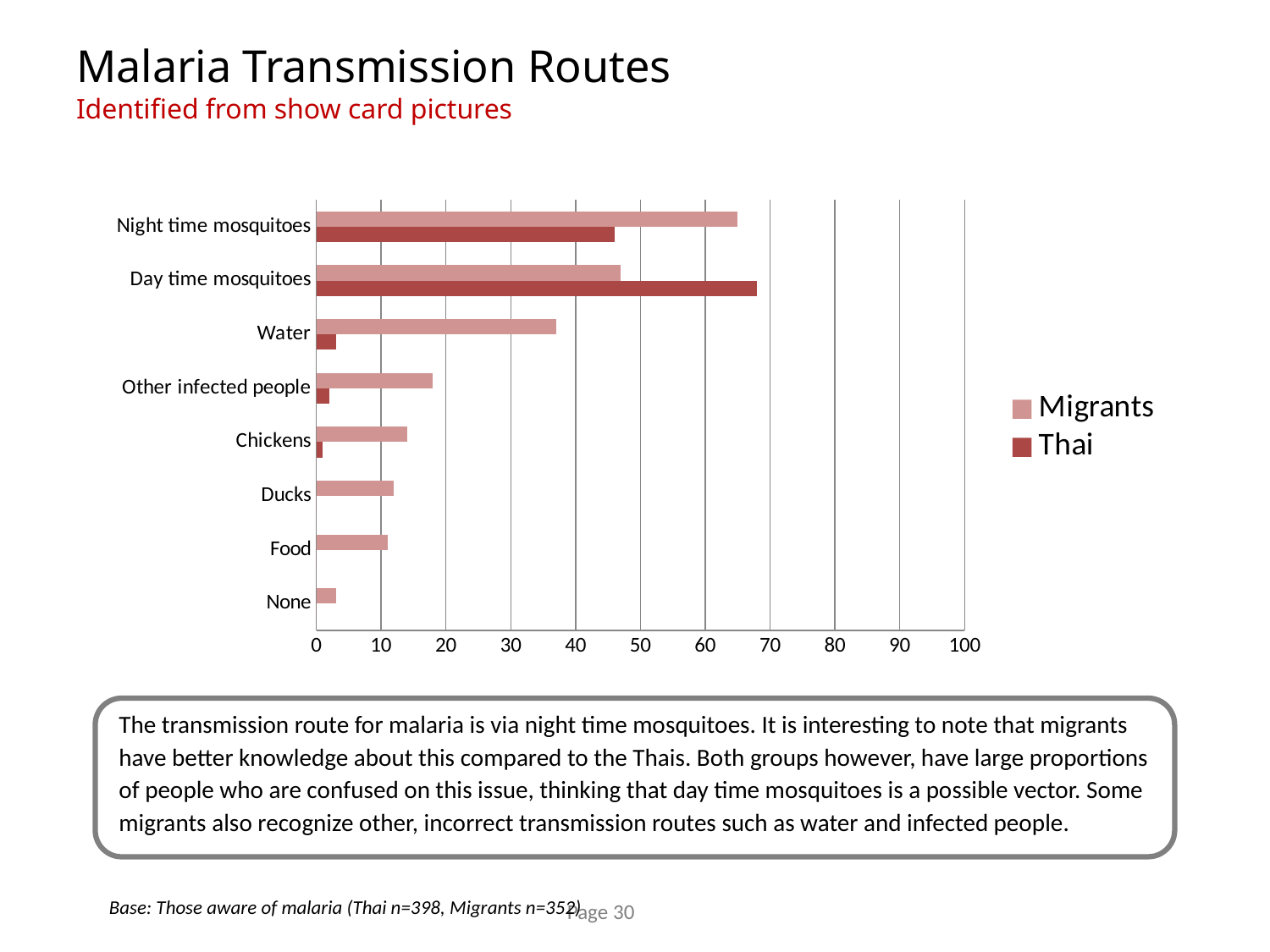
Which category has the lowest value for Migrants? None What kind of chart is shown on the slide? bar chart For Night time mosquitoes, which series has the larger value, Migrants or Thai? Migrants Which category has the highest value for Thai? Day time mosquitoes What is the title of the slide containing the chart? Malaria Transmission Routes Is the Migrants value for Water greater or less than 30? greater For Day time mosquitoes, which series has the larger value, Migrants or Thai? Thai How many transmission route categories are plotted on the chart? 8 Which category has the highest value for Migrants? Night time mosquitoes Is the Migrants value for Night time mosquitoes greater or less than 60? greater Is the Thai value for Water greater or less than 10? less How many series does the legend list? 2